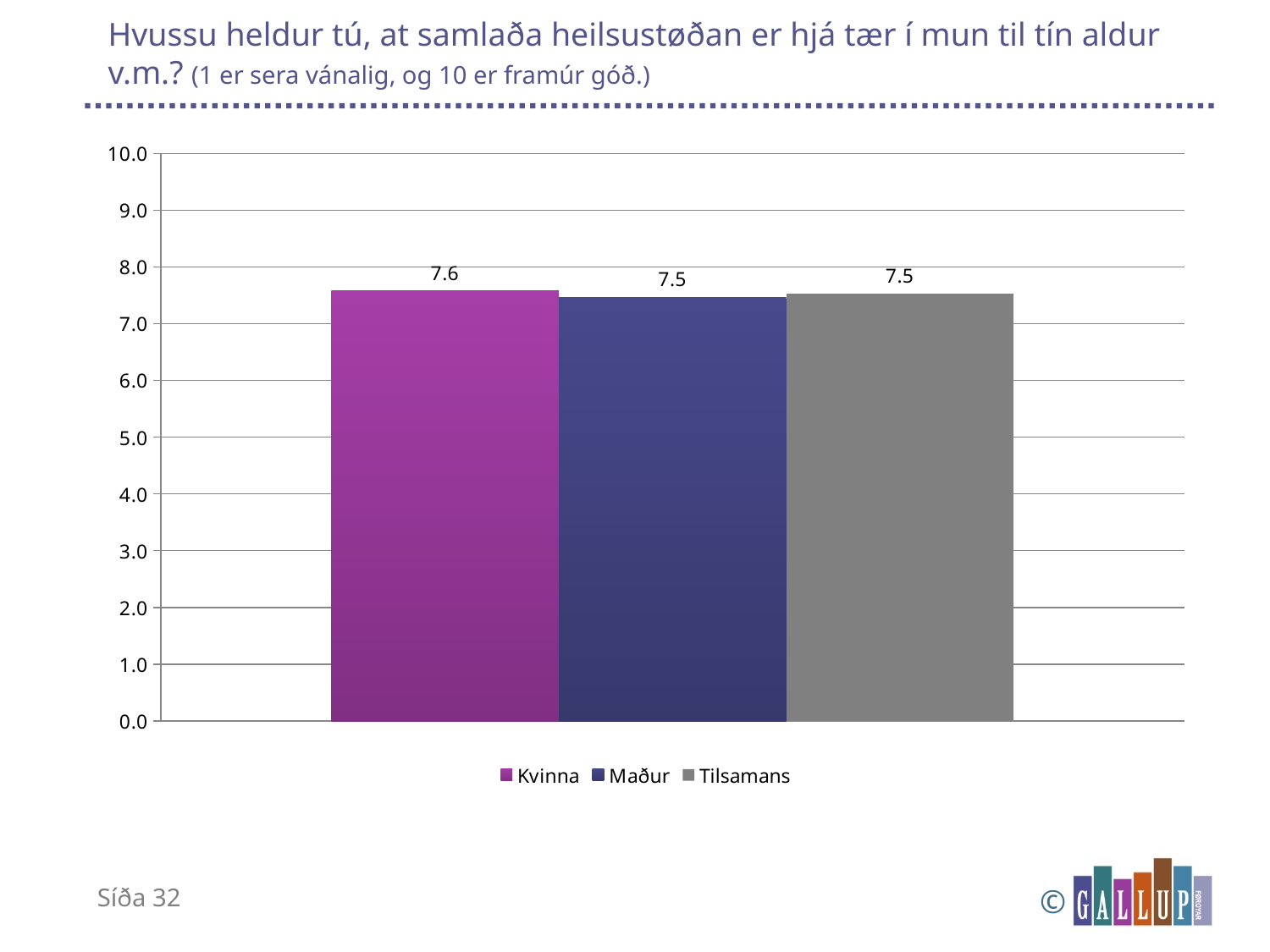
How many bars are plotted in the chart? 3 Which is larger, the value for Kvinna or the value for Tilsamans? Kvinna Which series has the highest value? Kvinna What kind of chart is shown on the slide? bar chart What is the value for Kvinna? 7.6 What is the value for Tilsamans? 7.5 Is the value for Tilsamans greater or less than 8.0? less What is the maximum value shown on the vertical axis? 10.0 What is the difference between the values for Kvinna and Maður? 0.1 What is the value for Maður? 7.5 Is the value for Kvinna greater or less than 5.0? greater How many series does the legend list? 3